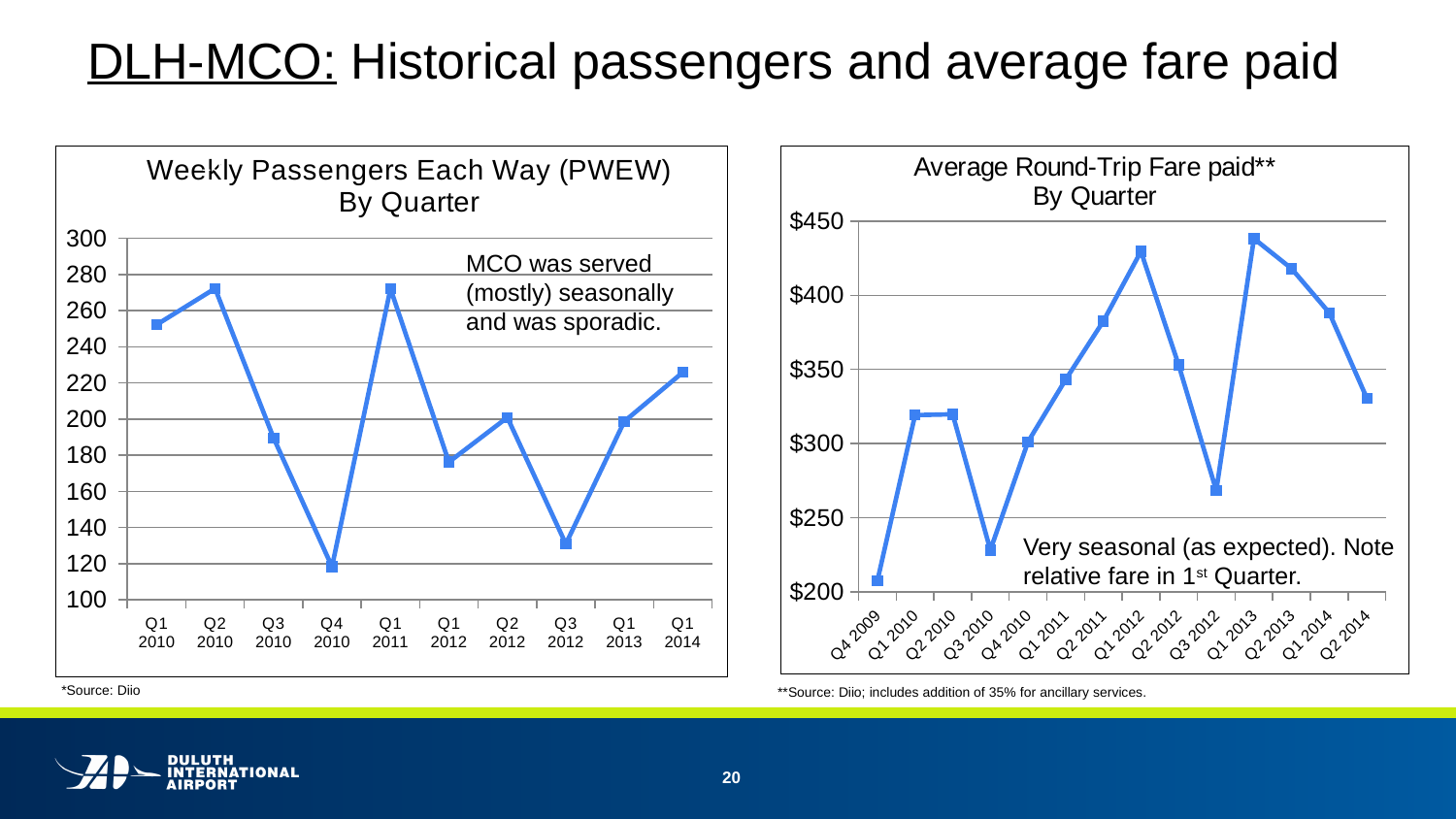
On the 'Weekly Passengers Each Way (PWEW) By Quarter' chart, which is larger, the value for Q1 2010 or Q3 2010? Q1 2010 On the 'Average Round-Trip Fare paid By Quarter' chart, which is larger, the fare for Q2 2011 or Q2 2012? Q2 2011 How many quarters are plotted on the 'Average Round-Trip Fare paid By Quarter' chart? 14 On the 'Weekly Passengers Each Way (PWEW) By Quarter' chart, do the values rise or fall from Q2 2010 to Q4 2010? fall On the 'Average Round-Trip Fare paid By Quarter' chart, do the values rise or fall from Q1 2013 to Q2 2014? fall On the 'Average Round-Trip Fare paid By Quarter' chart, is the value for Q1 2012 greater or less than $400? greater On the 'Weekly Passengers Each Way (PWEW) By Quarter' chart, is the value for Q1 2010 greater or less than 240? greater On the 'Average Round-Trip Fare paid By Quarter' chart, which quarter has the lowest fare? Q4 2009 How many quarters are plotted on the 'Weekly Passengers Each Way (PWEW) By Quarter' chart? 10 On the 'Weekly Passengers Each Way (PWEW) By Quarter' chart, which quarter has the lowest value? Q4 2010 What type of chart is the 'Weekly Passengers Each Way (PWEW) By Quarter' chart? line chart On the 'Weekly Passengers Each Way (PWEW) By Quarter' chart, is the value for Q4 2010 greater or less than 140? less